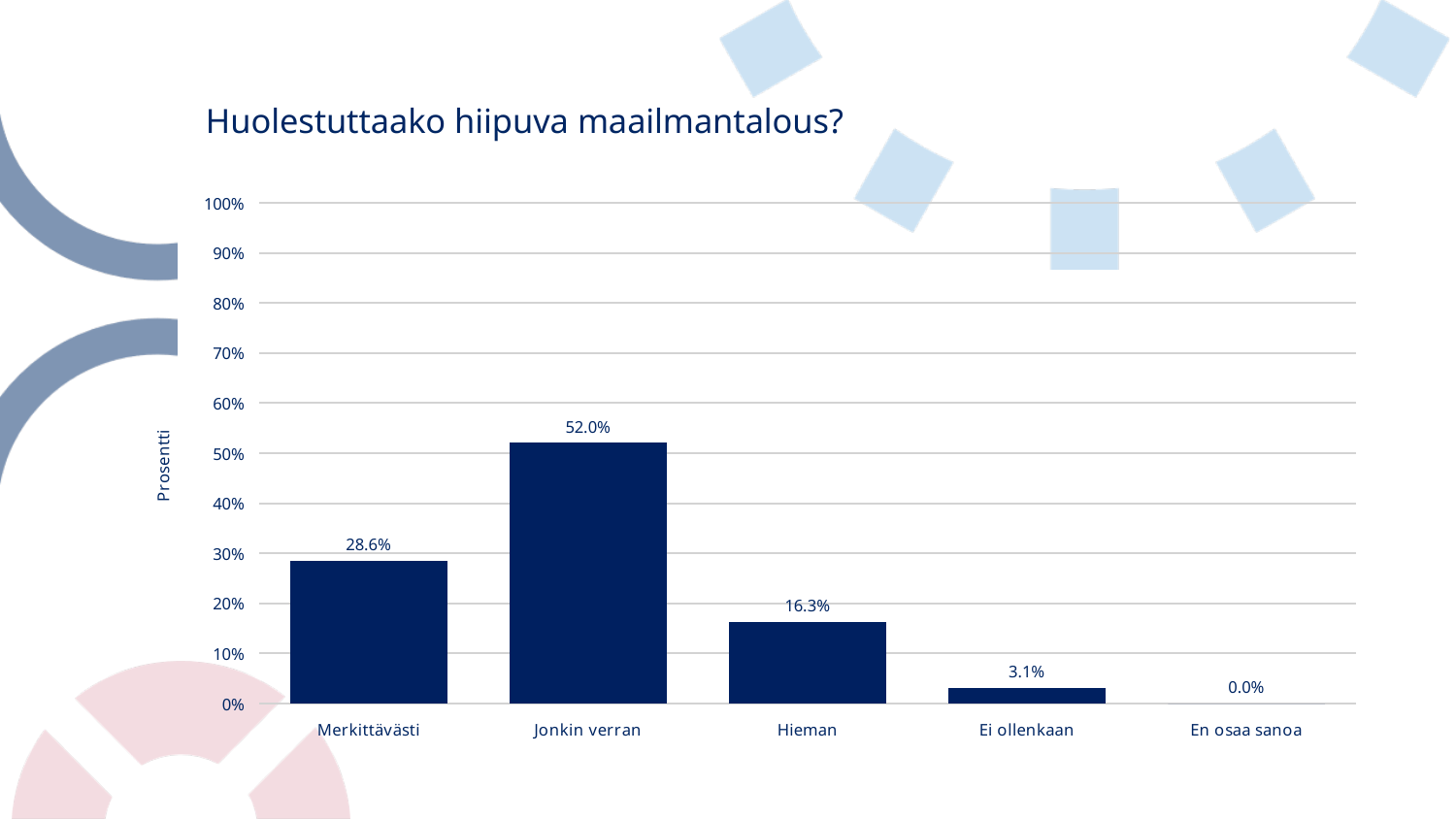
What kind of chart is shown on the slide? bar chart What is the difference between the values for Jonkin verran and Merkittävästi? 23.4% Which category has the highest value? Jonkin verran What is the value for Jonkin verran? 52.0% Which is larger, the value for Hieman or the value for Ei ollenkaan? Hieman Is the value for Hieman greater or less than 20%? less How many categories are shown on the x axis? 5 Which category has the lowest value? En osaa sanoa What is the value for En osaa sanoa? 0.0% What is the value for Merkittävästi? 28.6% What is the title of the chart? Huolestuttaako hiipuva maailmantalous? What is the value for Ei ollenkaan? 3.1%